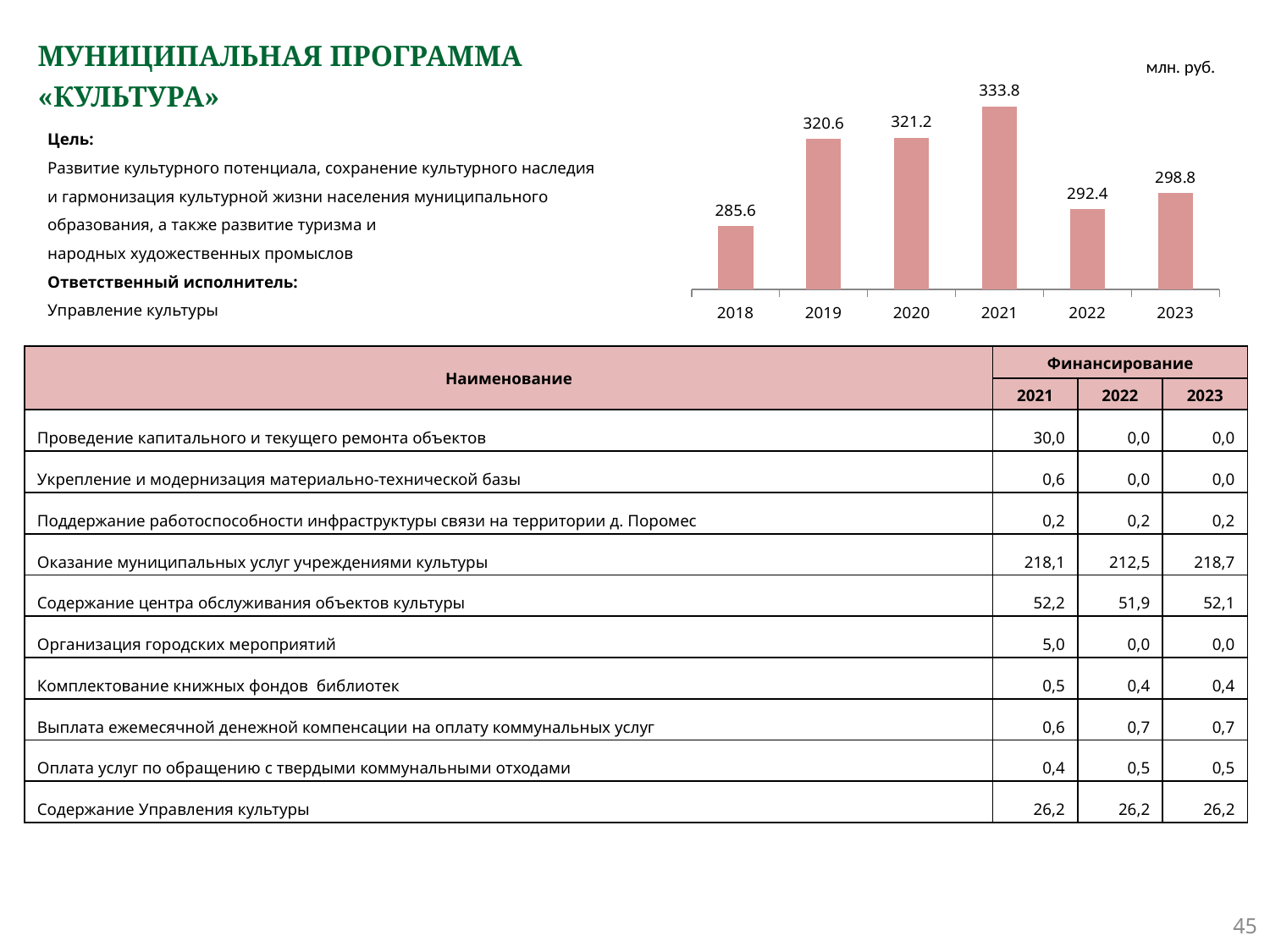
What is the value for 2022 in the bar chart? 292.4 Which is larger in the bar chart, the value for 2023 or the value for 2022? 2023 What kind of chart is shown on the slide? bar chart How many years are shown on the x axis of the bar chart? 6 Which year has the highest value in the bar chart? 2021 What is the value for 2021 in the bar chart? 333.8 What is the value for 2018 in the bar chart? 285.6 What is the difference between the values for 2019 and 2018 in the bar chart? 35.0 Which year has the lowest value in the bar chart? 2018 What unit is indicated for the values in the bar chart? млн. руб. Do the values in the bar chart rise or fall from 2018 to 2021? rise What is the difference between the values for 2021 and 2022 in the bar chart? 41.4